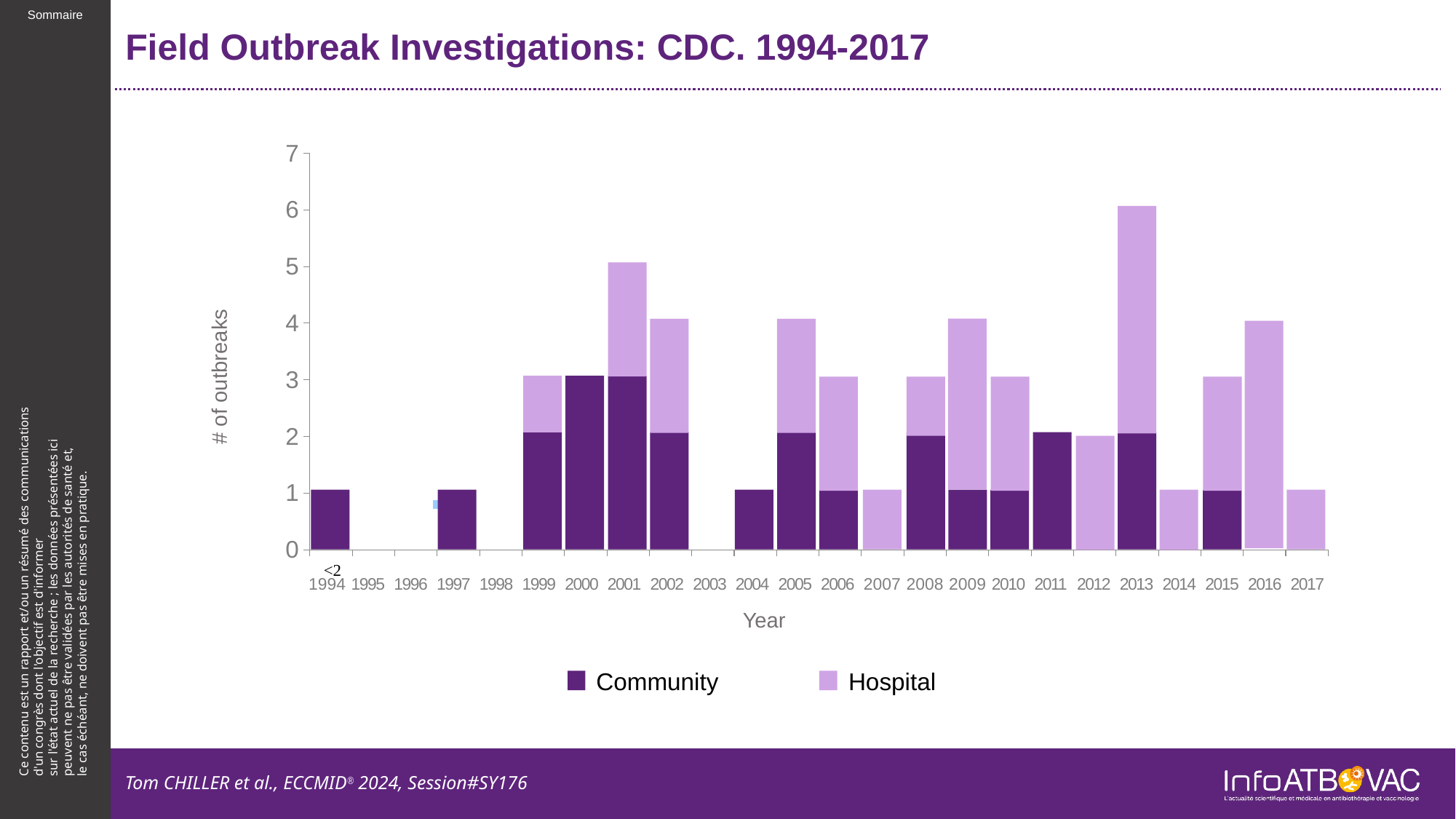
How many years are shown along the x axis? 24 What is the Hospital value for 2012? 2 How many series does the legend list? 2 What are the two entries in the legend? Community and Hospital Is the total number of outbreaks for 2016 greater or less than 3? greater What is the Community value for 2000? 3 What is the total number of outbreaks for 2013? 6 What kind of chart is shown on the slide? bar chart What is the label of the y axis? # of outbreaks Which year has a larger total number of outbreaks, 2001 or 2002? 2001 Is the total number of outbreaks for 2001 greater or less than 4? greater Which year has the highest total number of outbreaks? 2013